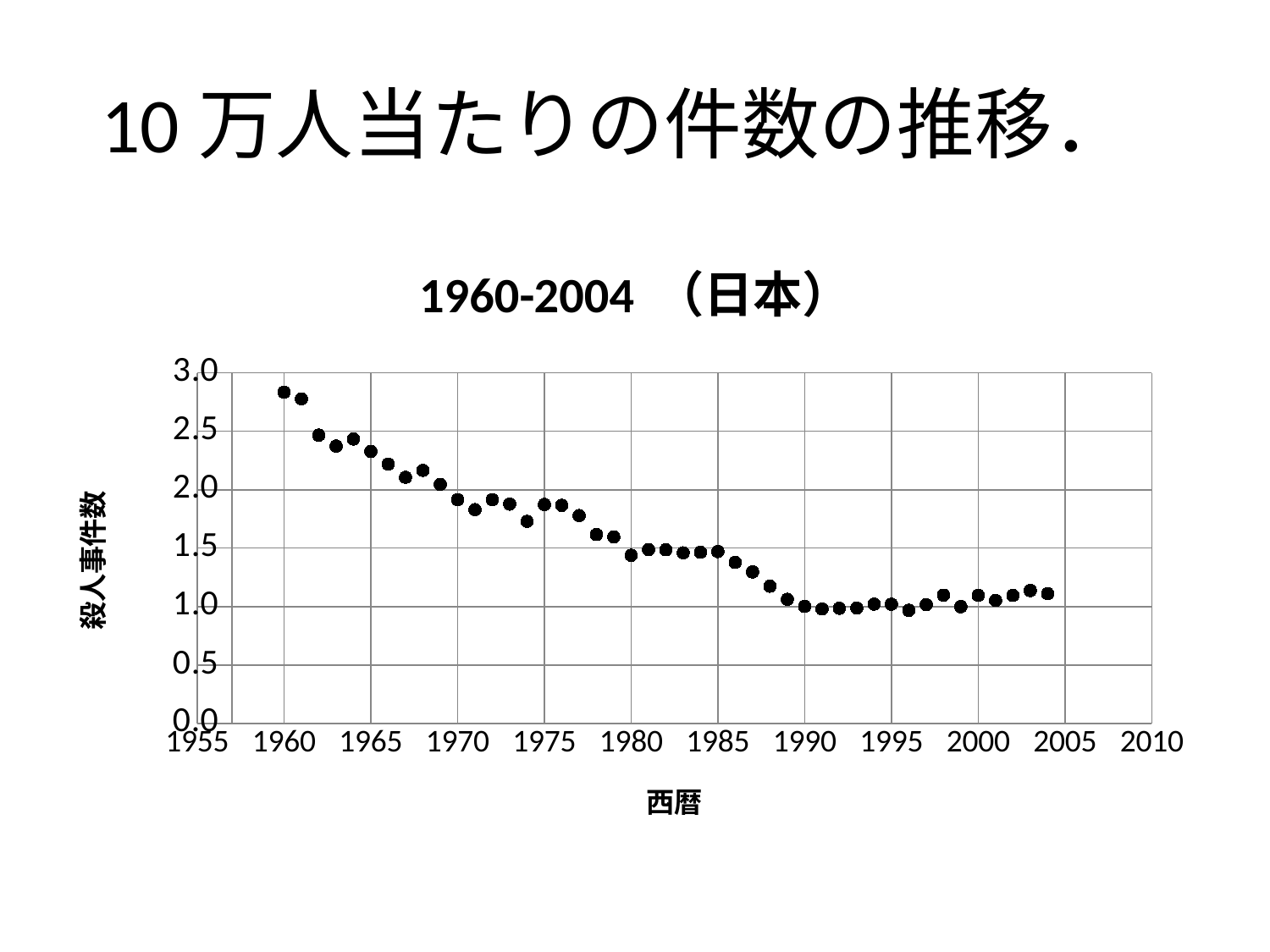
Which is larger, the value for 1960 or the value for 2004? 1960 Do the values generally rise or fall from 1960 to 2004? fall What is the label of the vertical axis? 殺人事件数 What is the title of the chart? 1960-2004 （日本） Is the value for 1975 greater or less than 2.0? less Is the value for 2004 greater or less than 1.5? less Is the value for 1960 greater or less than 2.5? greater What kind of chart is shown on the slide? scatter chart Which year has the highest value? 1960 Which is larger, the value for 1970 or the value for 1980? 1970